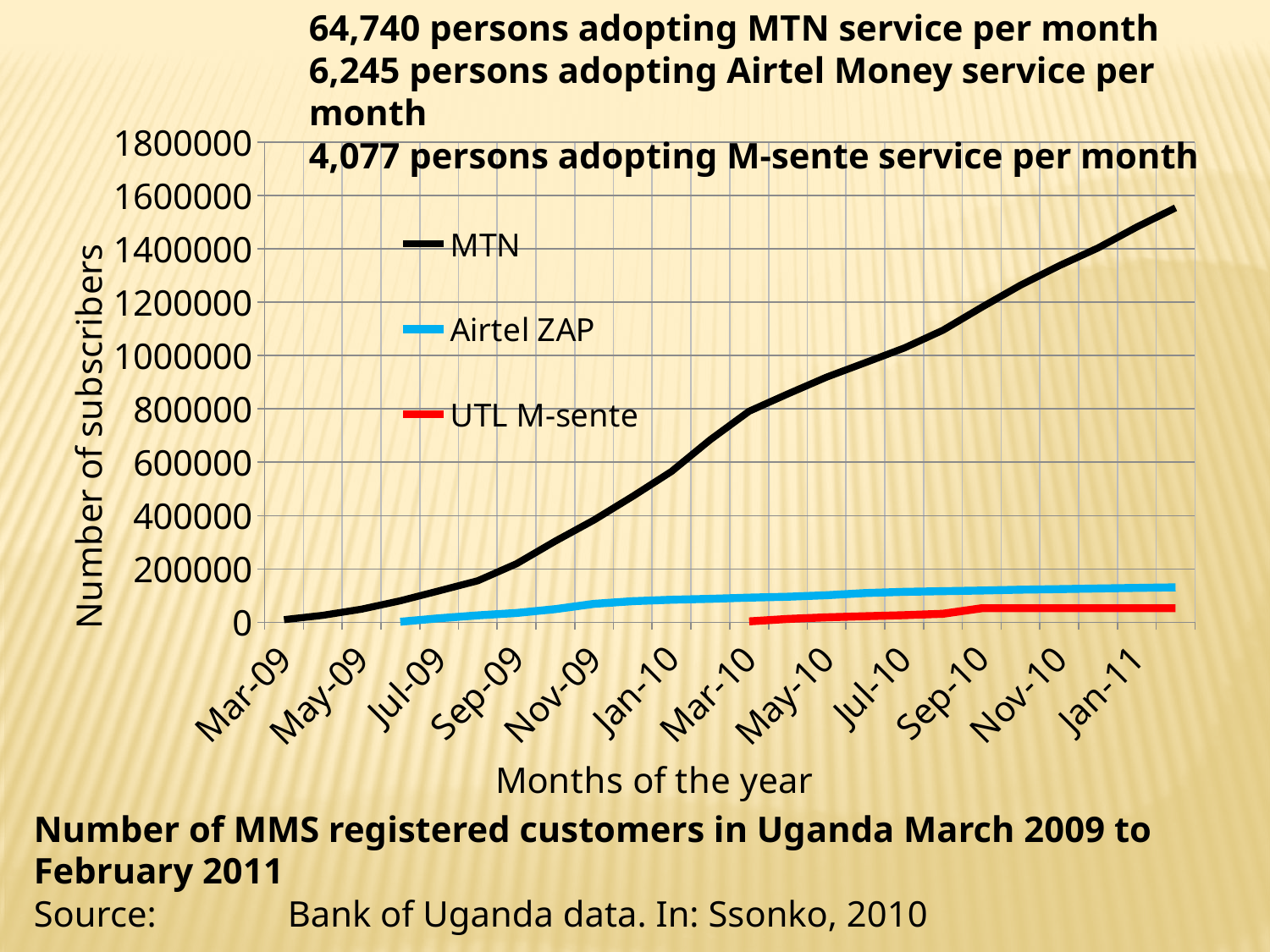
What kind of chart is shown on the slide? line chart Does the MTN line rise or fall from Mar-09 to Jan-11? rise What is the title of the chart's vertical axis? Number of subscribers At Jan-11, which is larger: Airtel ZAP or UTL M-sente? Airtel ZAP Which series has the highest number of subscribers at Jan-11? MTN Which series are listed in the chart's legend? MTN, Airtel ZAP, UTL M-sente Which series has the lowest number of subscribers at Jan-11? UTL M-sente How many month labels are shown on the x axis? 12 Is the value for Airtel ZAP at Jan-11 greater or less than 200000? less Is the value for MTN at Jan-11 greater or less than 1200000? greater Is the value for MTN at Mar-10 greater or less than 600000? greater How many series does the chart's legend list? 3